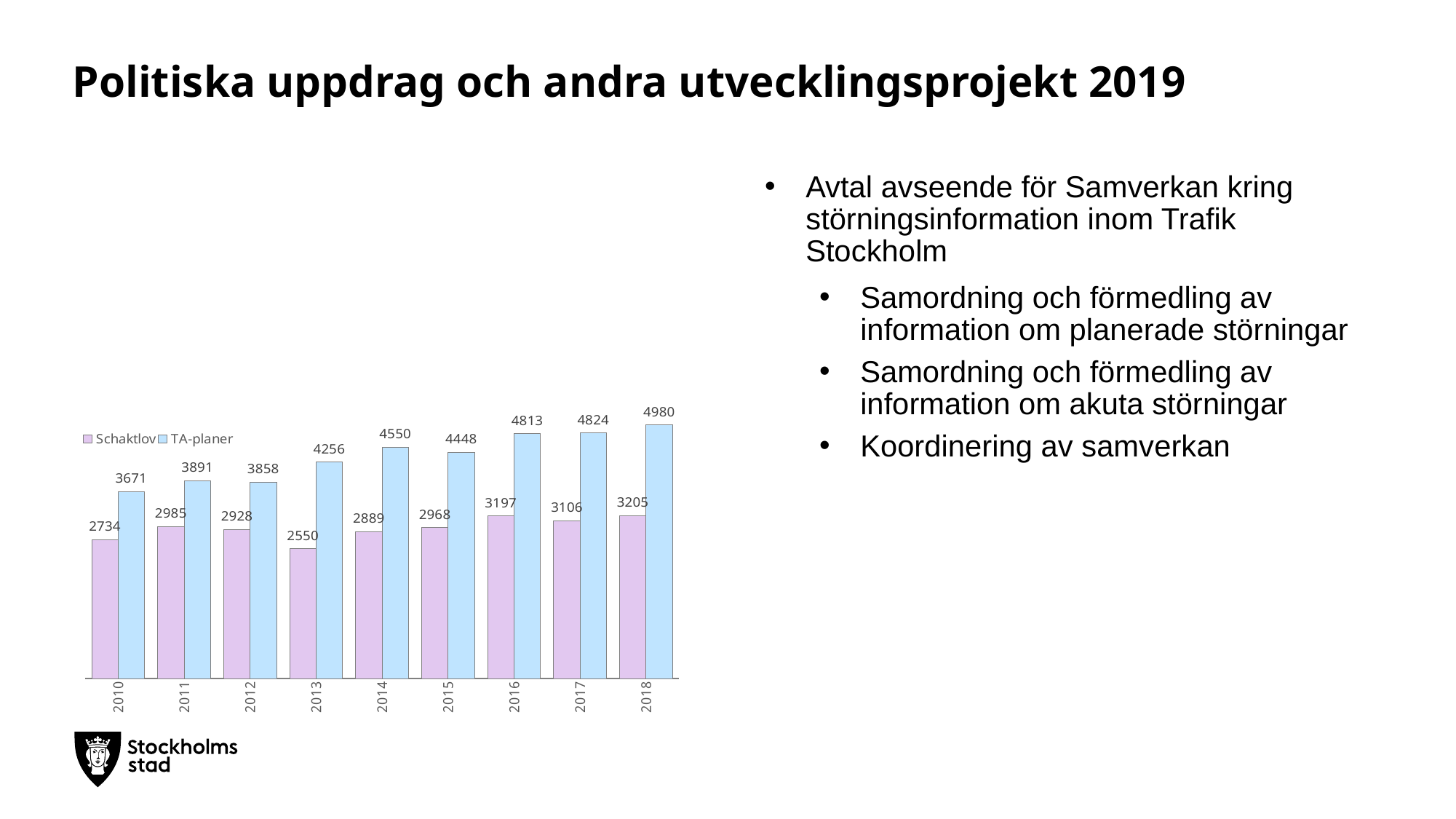
What is the difference between TA-planer and Schaktlov in 2018? 1775 Which year has the lowest value for Schaktlov? 2013 What kind of chart is shown on the slide? Bar chart What is the value for Schaktlov in 2010? 2734 Which year has the highest value for TA-planer? 2018 Does the value for TA-planer generally rise or fall from 2010 to 2018? Rise How many series does the legend list? 2 How many years are shown on the x axis? 9 What are the two series named in the chart legend? Schaktlov and TA-planer What is the value for TA-planer in 2018? 4980 What is the value for TA-planer in 2013? 4256 Which is larger in 2016: Schaktlov or TA-planer? TA-planer